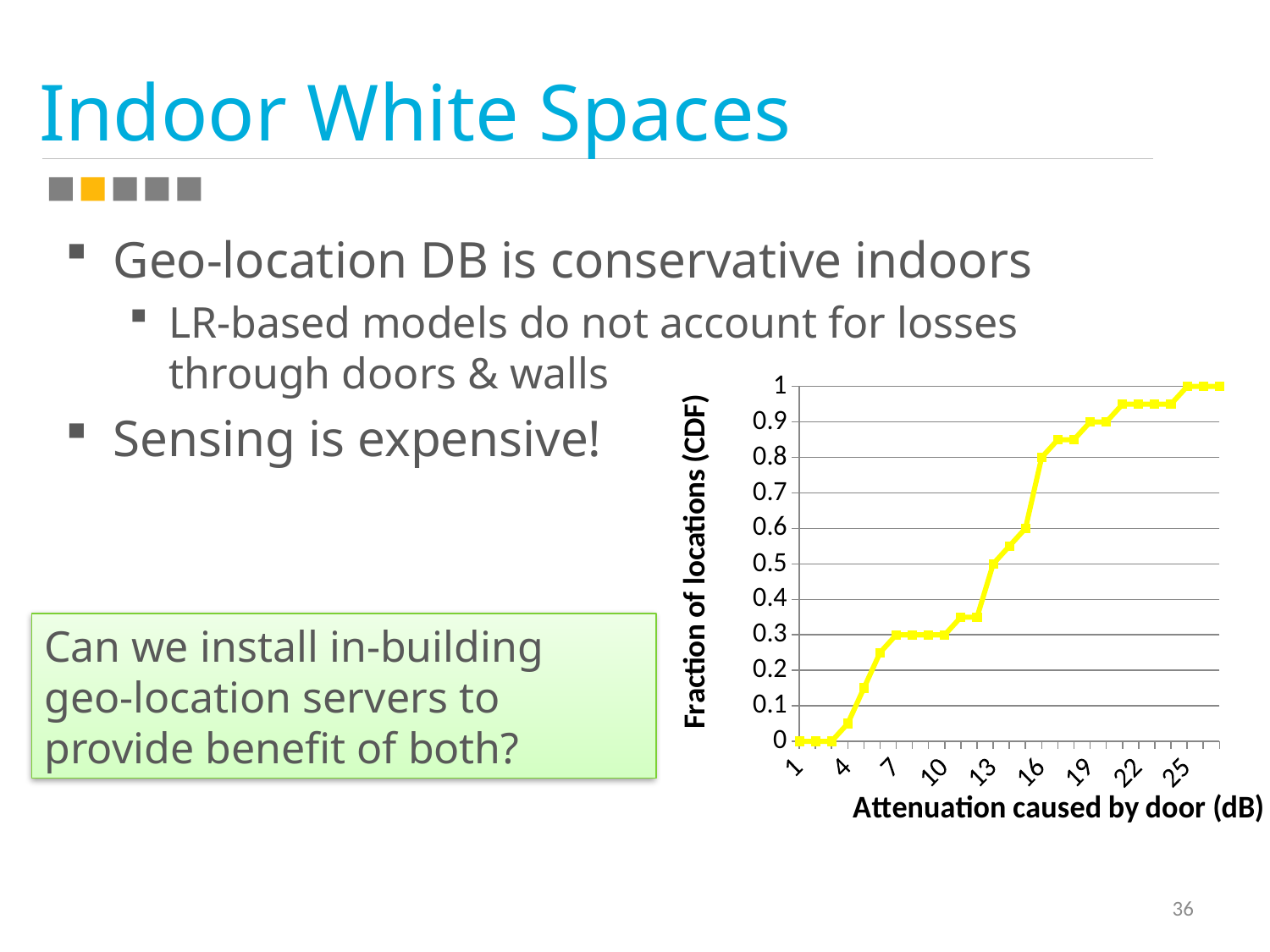
What kind of chart is shown on the slide? line chart Is the fraction of locations at 16 dB greater or less than 0.5? greater What is the fraction of locations at an attenuation of 7 dB? 0.3 What is the title of the y axis of the chart? Fraction of locations (CDF) Do the values on the chart rise or fall as attenuation increases along the x axis? rise Is the fraction of locations at 19 dB greater or less than 0.8? greater What is the fraction of locations at an attenuation of 1 dB? 0 Is the fraction of locations at 4 dB greater or less than 0.1? less Which has the larger fraction of locations: 13 dB or 19 dB? 19 dB What is the title of the x axis of the chart? Attenuation caused by door (dB)